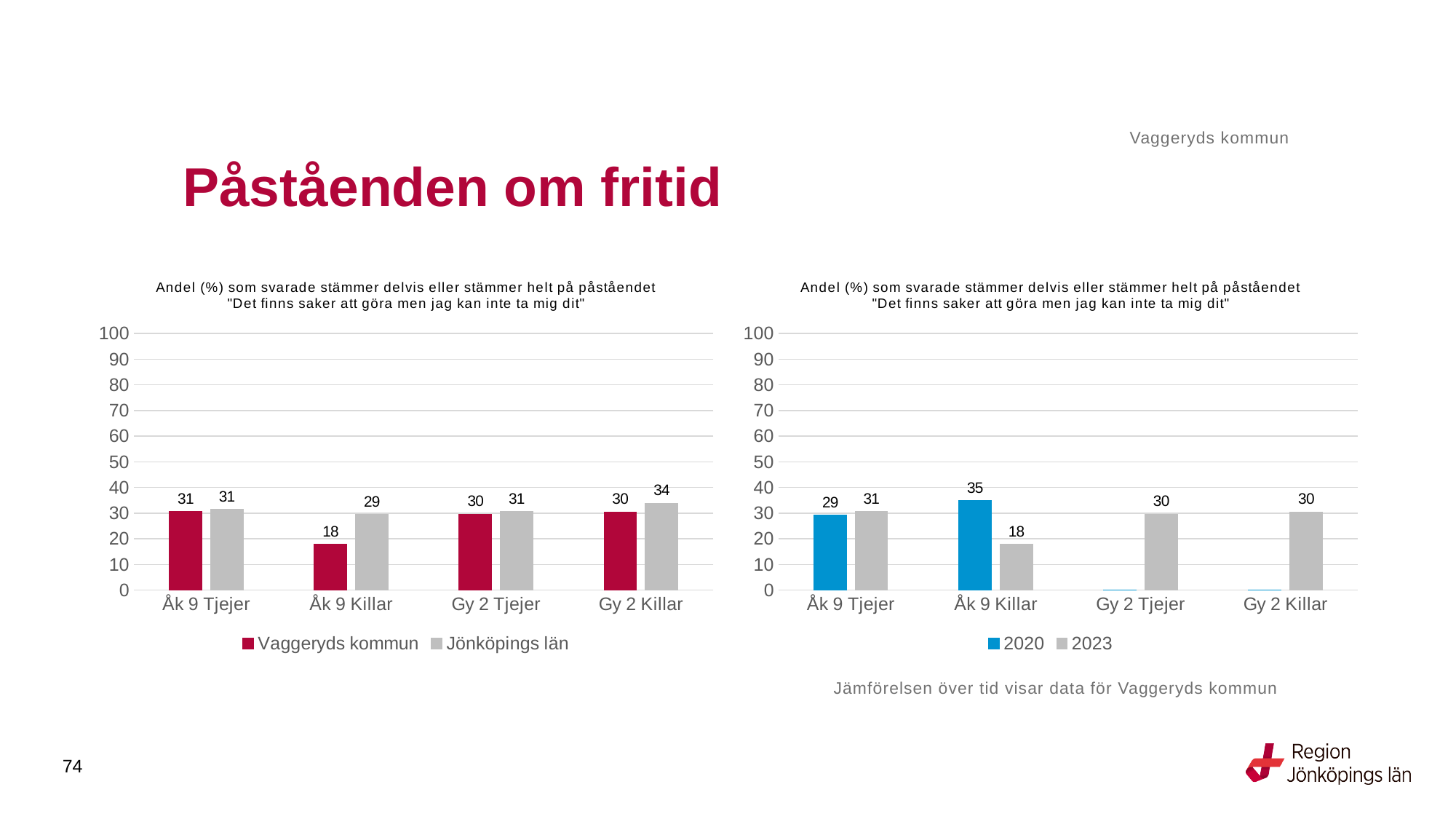
How many series does the legend of the left chart list? 2 In the right chart, what is the value for 2023 for Gy 2 Tjejer? 30 In the right chart, what is the difference between 2020 and 2023 for Åk 9 Killar? 17 What type of chart is the right chart? Bar chart In the left chart, what is the value for Jönköpings län for Gy 2 Killar? 34 In the right chart, what is the value for 2020 for Åk 9 Killar? 35 In the left chart, what is the difference between Jönköpings län and Vaggeryds kommun for Åk 9 Killar? 11 In the left chart, what is the value for Vaggeryds kommun for Åk 9 Killar? 18 In the right chart, which category has the highest value for 2020? Åk 9 Killar In the left chart, which is larger for Gy 2 Killar: Vaggeryds kommun or Jönköpings län? Jönköpings län How many categories are shown on the x axis of the right chart? 4 In the left chart, which category has the lowest value for Vaggeryds kommun? Åk 9 Killar